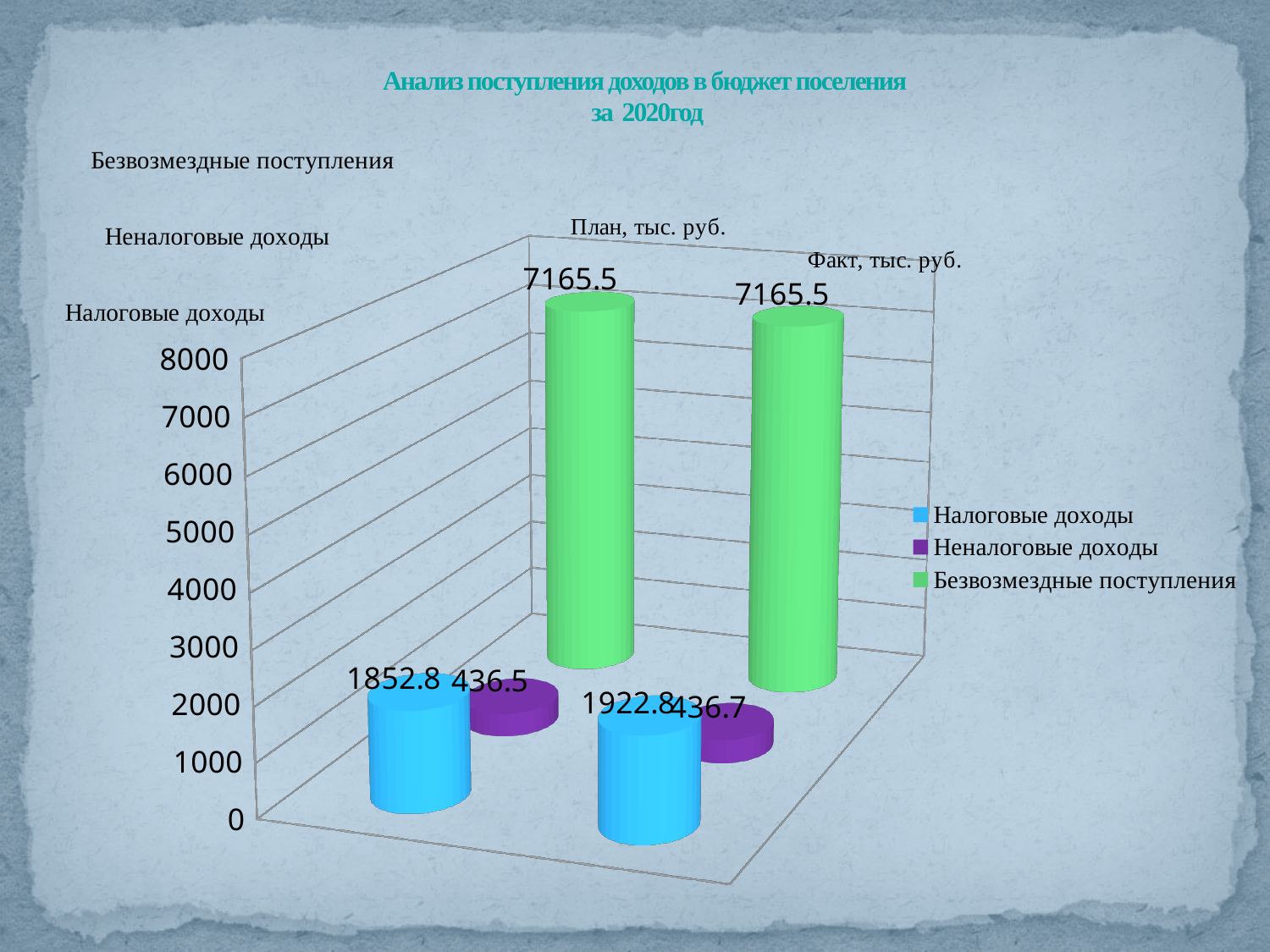
What colour are the bars for Безвозмездные поступления? Green What is the value of Неналоговые доходы for План, тыс. руб.? 436.5 What is the value of Налоговые доходы for Факт, тыс. руб.? 1922.8 What is the value of Налоговые доходы for План, тыс. руб.? 1852.8 Which series has the lowest value for Факт, тыс. руб.? Неналоговые доходы What is the value of Безвозмездные поступления for Факт, тыс. руб.? 7165.5 What kind of chart is shown on the slide? Bar chart How many series does the legend list? 3 Which is larger: Налоговые доходы for План or Налоговые доходы for Факт? Факт What is the difference between the Факт and План values for Налоговые доходы? 70 What is the value of Неналоговые доходы for Факт, тыс. руб.? 436.7 Which series has the highest value for План, тыс. руб.? Безвозмездные поступления